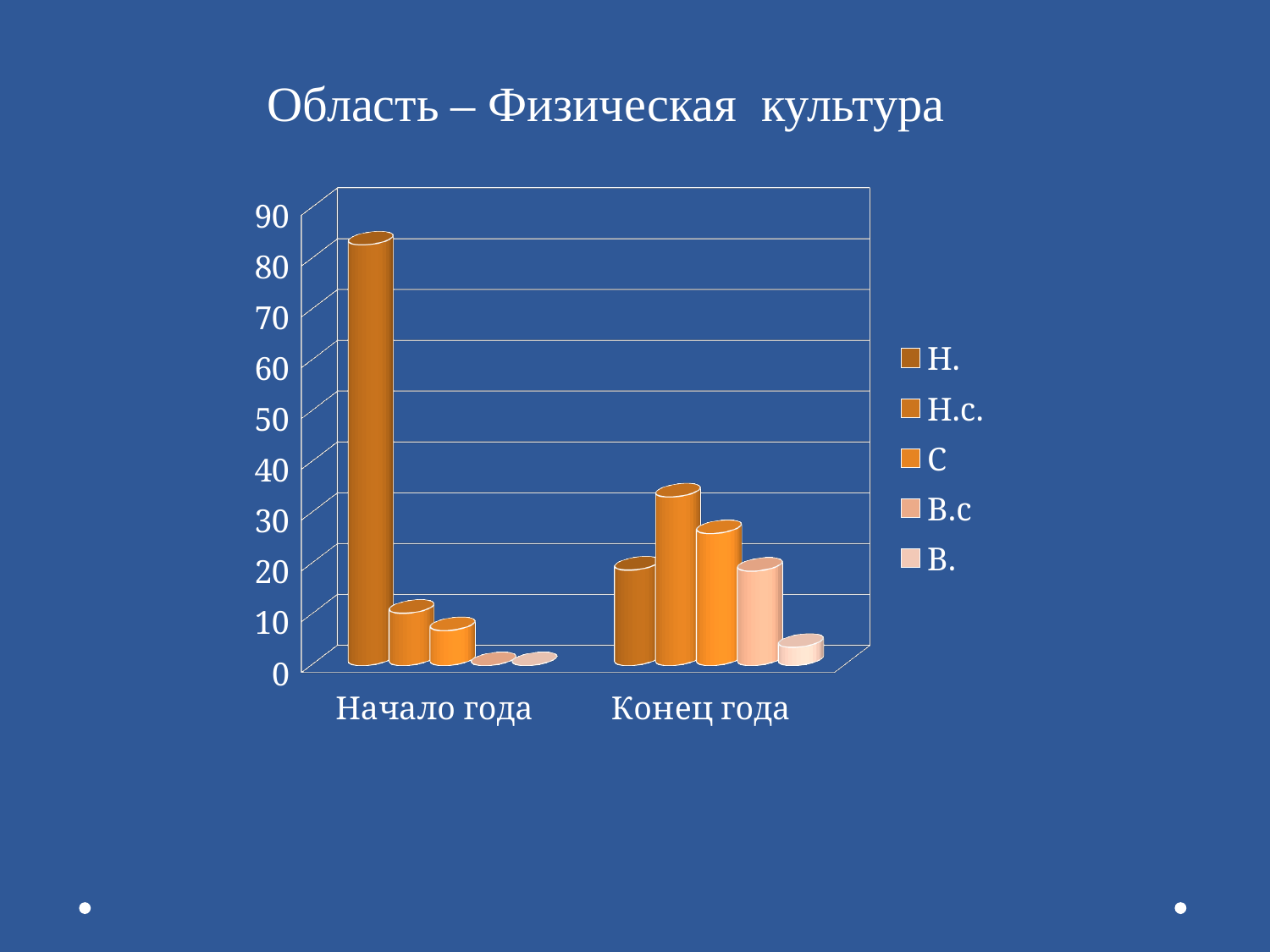
Which series has the highest value for Начало года? Н. Is the value of Н. for Начало года greater or less than 70? greater Which series has the lowest value for Конец года? В. Which is larger: the value of Н. for Начало года or for Конец года? Начало года Which series has the highest value for Конец года? Н.с. Is the value of В. for Конец года greater or less than 10? less Does the value of Н.с. rise or fall from Начало года to Конец года? rise What is the title of the slide? Область – Физическая культура Is the value of Н.с. for Конец года greater or less than 20? greater What kind of chart is shown on the slide? bar chart How many series does the legend list? 5 How many categories are shown on the x axis? 2